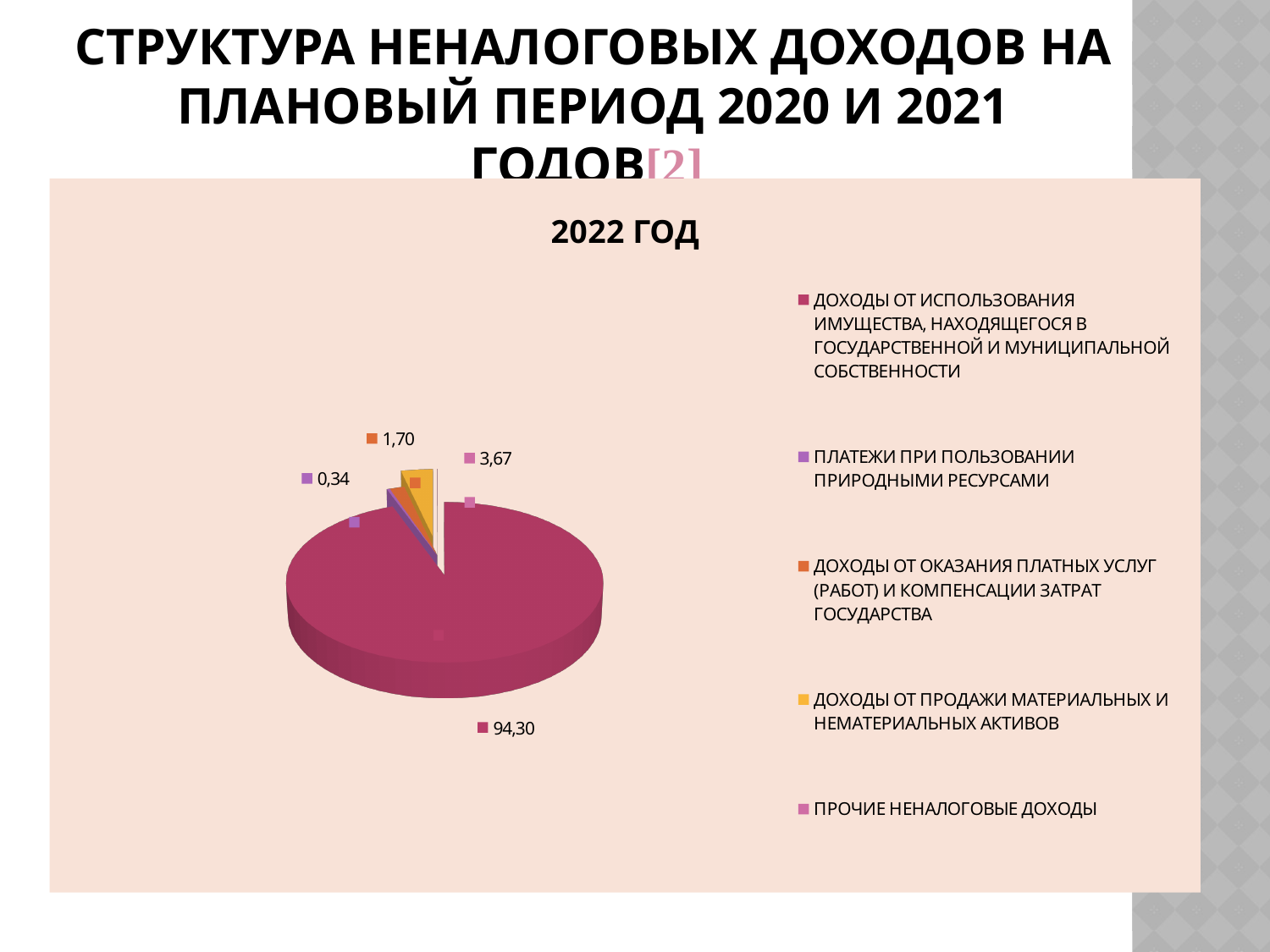
What kind of chart is shown on the slide? pie chart What is the value of the largest slice of the pie? 94,30 Is the value of the largest slice greater or less than 90? greater Which category has the largest share of the pie? ДОХОДЫ ОТ ИСПОЛЬЗОВАНИЯ ИМУЩЕСТВА, НАХОДЯЩЕГОСЯ В ГОСУДАРСТВЕННОЙ И МУНИЦИПАЛЬНОЙ СОБСТВЕННОСТИ What is the value labelled for ПЛАТЕЖИ ПРИ ПОЛЬЗОВАНИИ ПРИРОДНЫМИ РЕСУРСАМИ? 0,34 What is the difference between the slices labelled 3,67 and 1,70? 1,97 What is the smallest value labelled on the pie? 0,34 What colour is the largest slice of the pie? magenta What is the title of the chart? 2022 ГОД Which is larger, the slice labelled 1,70 or the slice labelled 0,34? 1,70 How many entries does the chart legend list? 5 What is the value labelled for ДОХОДЫ ОТ ОКАЗАНИЯ ПЛАТНЫХ УСЛУГ (РАБОТ) И КОМПЕНСАЦИИ ЗАТРАТ ГОСУДАРСТВА? 1,70